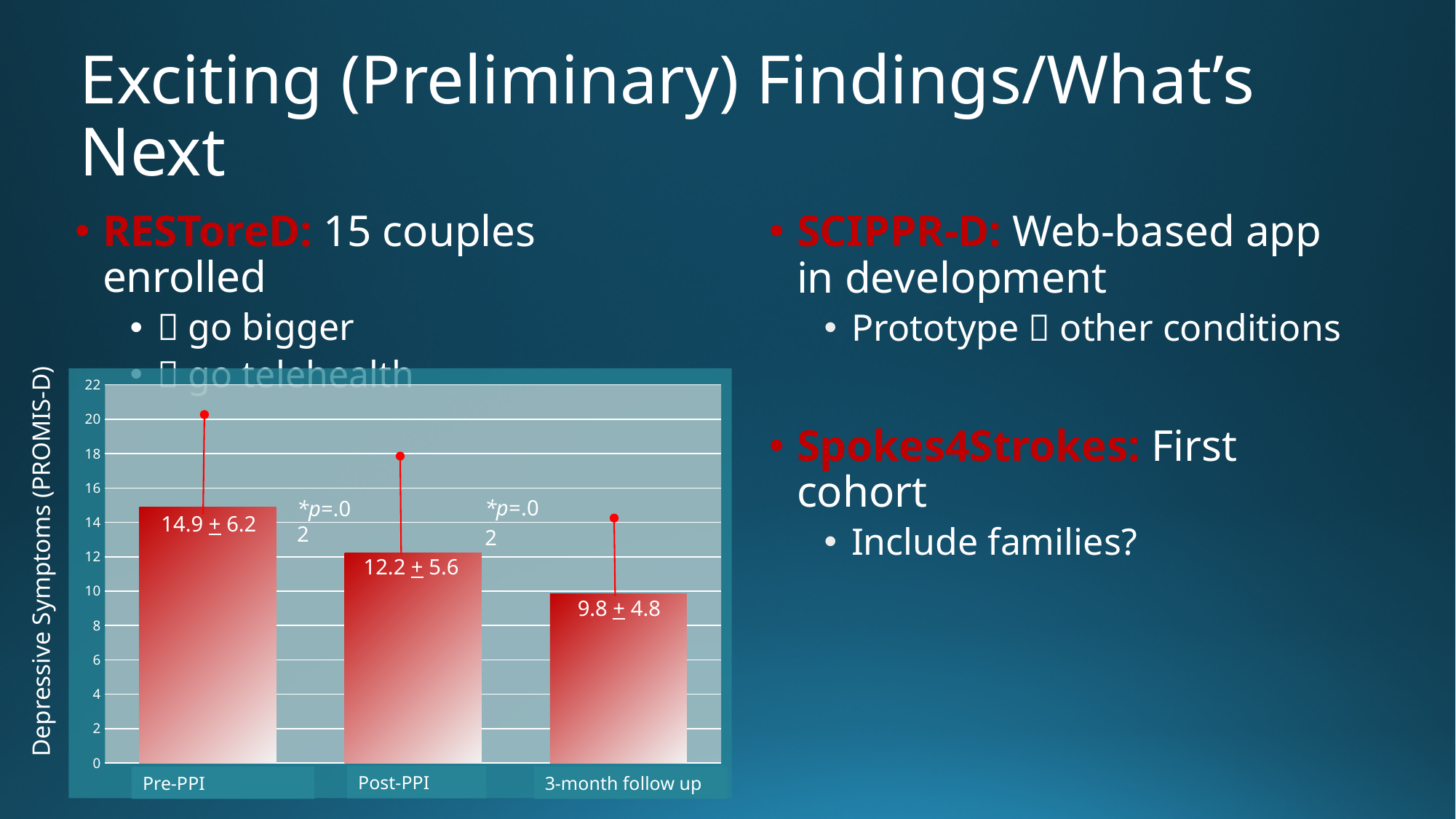
How many categories are shown on the x axis? 3 Do the mean values rise or fall from Pre-PPI to 3-month follow up? Fall What is the difference between the Pre-PPI and 3-month follow up mean values? 5.1 Which category has the lowest mean value? 3-month follow up What is the mean value shown for 3-month follow up? 9.8 Which is larger, the mean for Post-PPI or the mean for 3-month follow up? Post-PPI What is the mean value shown for Pre-PPI? 14.9 What is the difference between the Pre-PPI and Post-PPI mean values? 2.7 What is the standard deviation printed for the Pre-PPI bar? 6.2 Which category has the highest mean value? Pre-PPI What kind of chart is shown on the slide? Bar chart What is the mean value shown for Post-PPI? 12.2